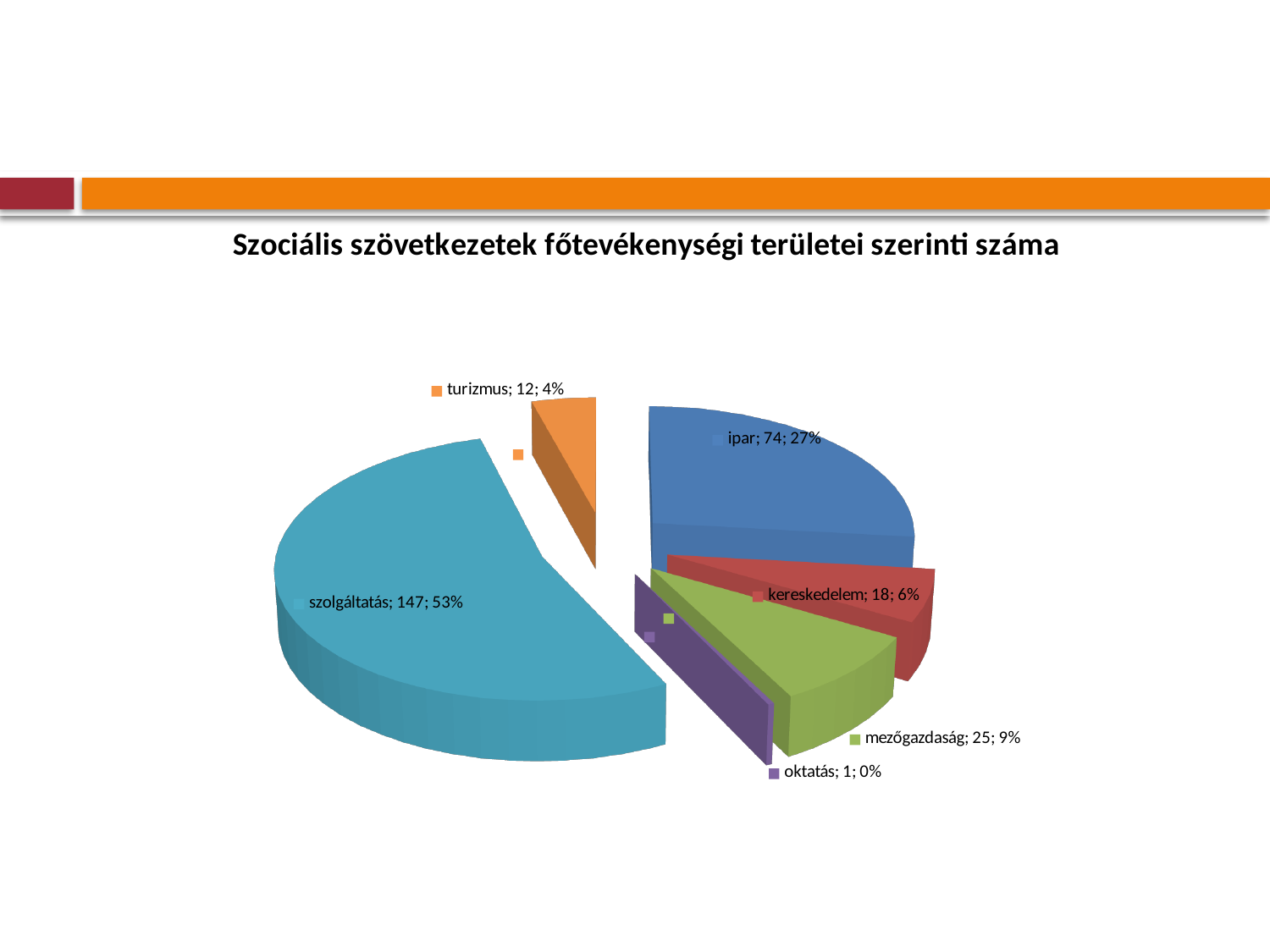
What kind of chart is shown on the slide? pie chart What is the value for kereskedelem? 18 Which category has the largest slice? szolgáltatás What share of the pie does turizmus represent? 4% What is the value for szolgáltatás? 147 Which category has the smallest slice? oktatás What is the difference between the values for szolgáltatás and ipar? 73 What share of the pie does szolgáltatás represent? 53% Which is larger, the value for mezőgazdaság or the value for kereskedelem? mezőgazdaság How many categories are shown in the pie chart? 6 What is the value for ipar? 74 What is the value for mezőgazdaság? 25